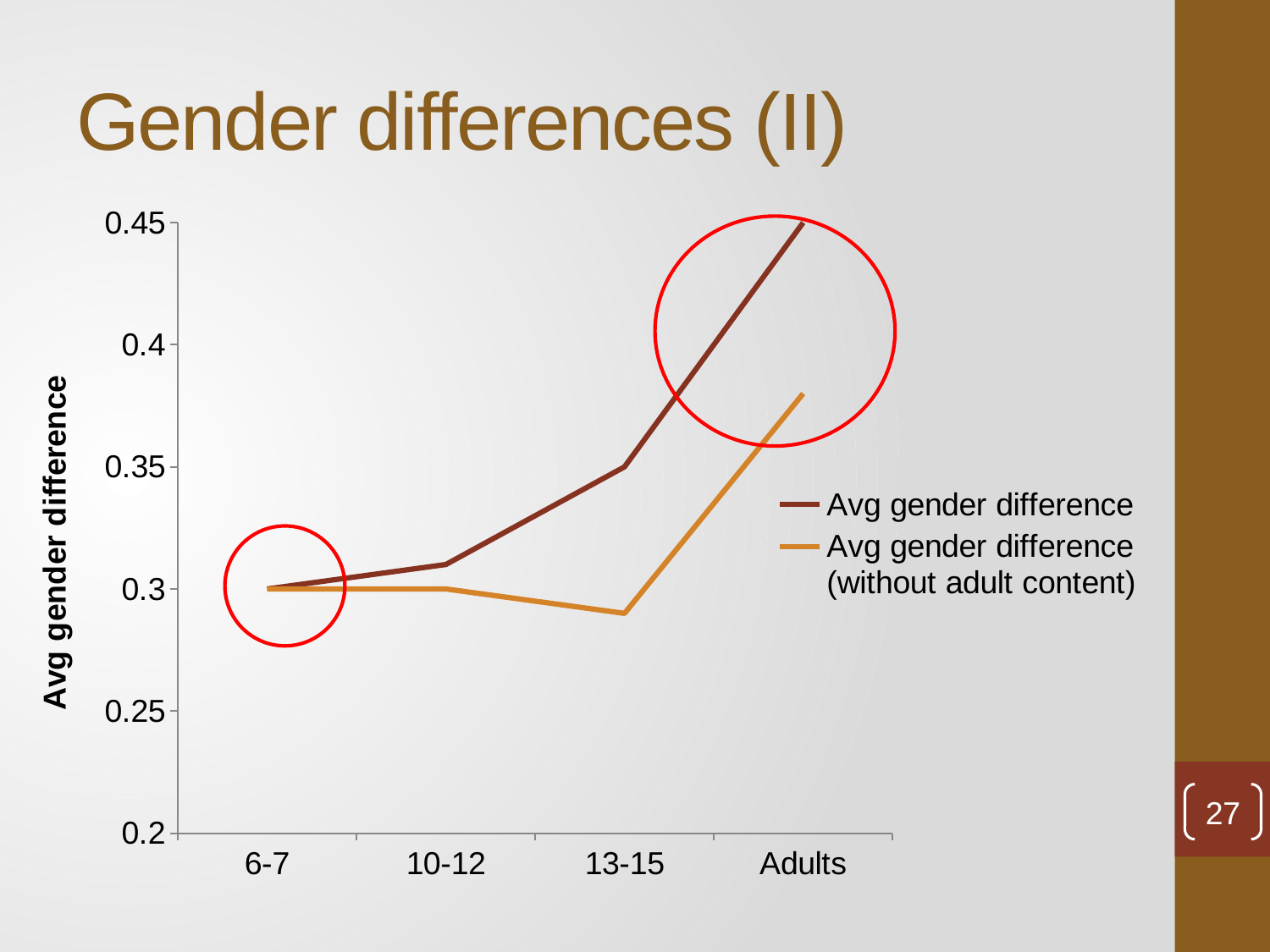
Is the value for 13-15 in the Avg gender difference (without adult content) series greater or less than 0.3? less For which age group is the Avg gender difference (without adult content) series highest? Adults What kind of chart is shown on the slide? line chart How many series does the legend list? 2 Is the value for Adults in the Avg gender difference (without adult content) series greater or less than 0.4? less What is the value of the Avg gender difference series for Adults? 0.45 How many age-group categories are shown on the x axis? 4 What is the value of the Avg gender difference (without adult content) series for the 10-12 age group? 0.3 For Adults, which series has the larger value: Avg gender difference or Avg gender difference (without adult content)? Avg gender difference For which age group is the Avg gender difference series highest? Adults Does the Avg gender difference series rise or fall from 6-7 to Adults? rise What is the value of the Avg gender difference series for the 6-7 age group? 0.3